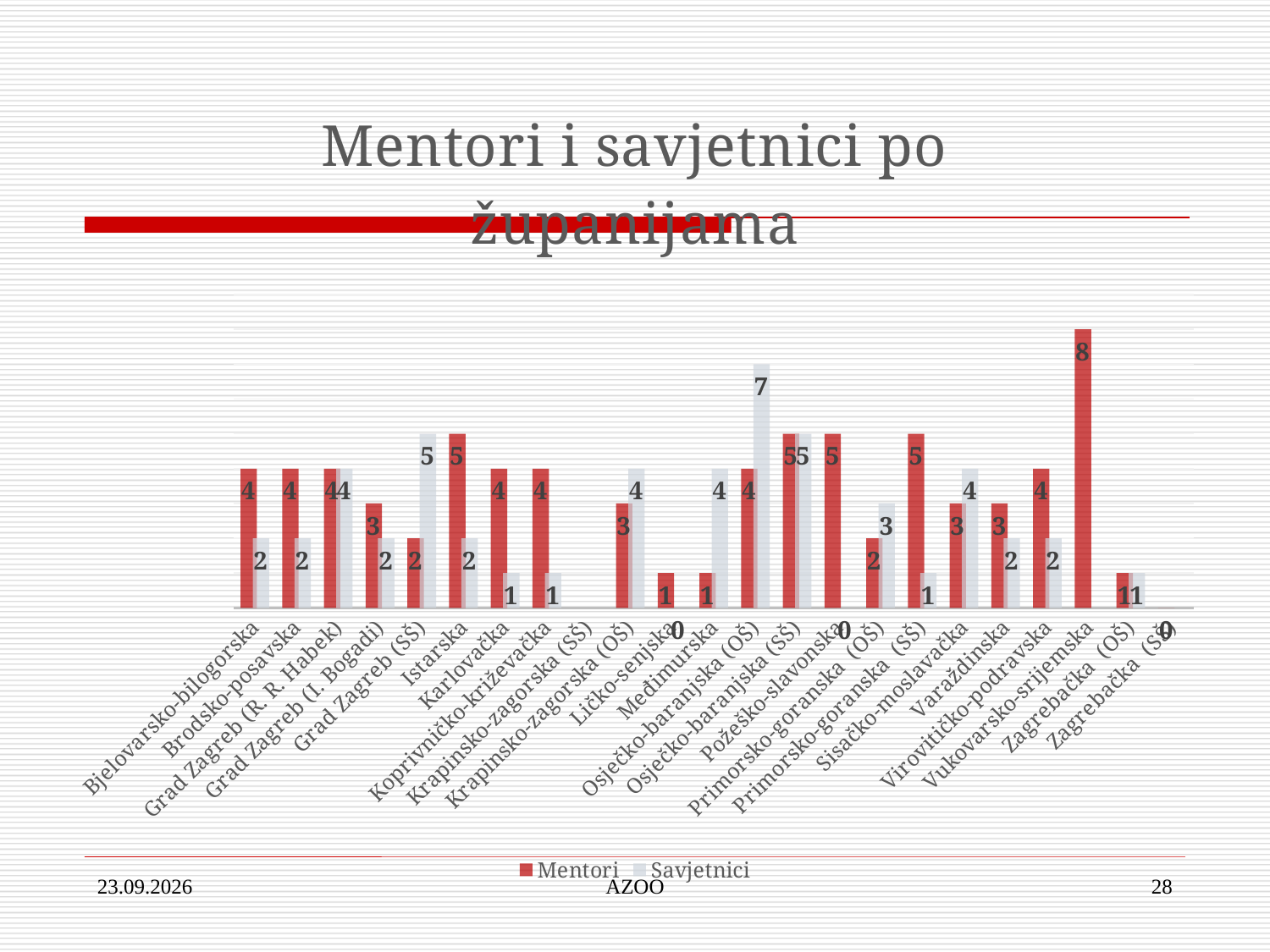
What is the Savjetnici value for Karlovačka? 1 For Grad Zagreb (SŠ), which is larger: Mentori or Savjetnici? Savjetnici What is the Mentori value for Primorsko-goranska (OŠ)? 2 How many series does the legend list? 2 What are the two series named in the legend? Mentori and Savjetnici Which category has the highest Mentori value? Vukovarsko-srijemska For Istarska, what is the difference between the Mentori and Savjetnici values? 3 For Osječko-baranjska (OŠ), how much larger is the Savjetnici value than the Mentori value? 3 What is the Savjetnici value for Osječko-baranjska (OŠ)? 7 What kind of chart is shown on the slide? bar chart Which category has the highest Savjetnici value? Osječko-baranjska (OŠ) What is the Mentori value for Istarska? 5